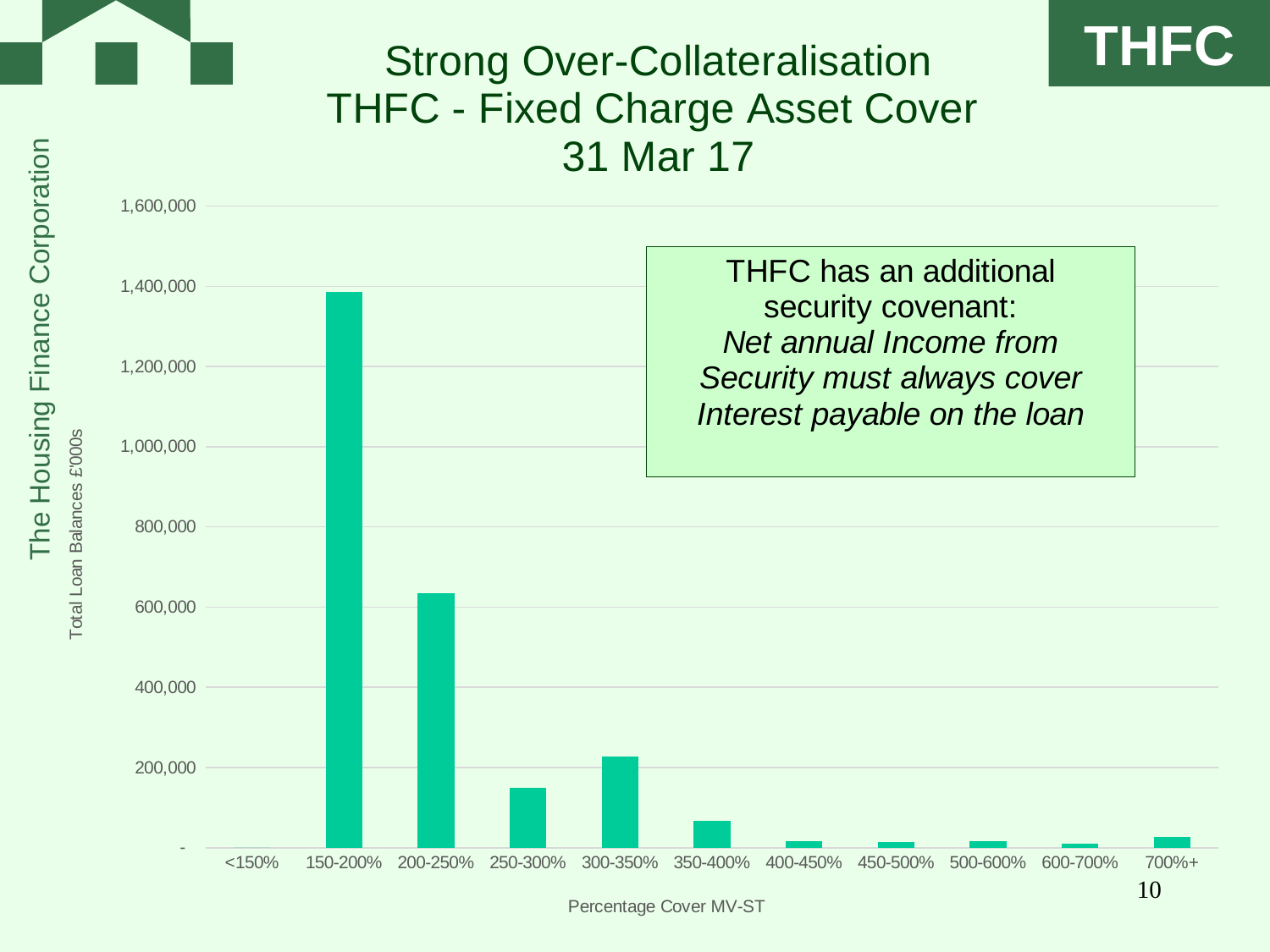
What is the title of the y axis? Total Loan Balances £'000s Which is larger, the value for 250-300% or the value for 300-350%? 300-350% Is the value for 200-250% greater or less than 800,000? less Which is larger, the value for 150-200% or the value for 200-250%? 150-200% What is the title of the x axis? Percentage Cover MV-ST Is the value for 250-300% greater or less than 200,000? less Is the value for 300-350% greater or less than 200,000? greater How many percentage cover categories are shown on the x axis? 11 Which percentage cover category has the highest total loan balance? 150-200% What kind of chart is shown on the slide? bar chart